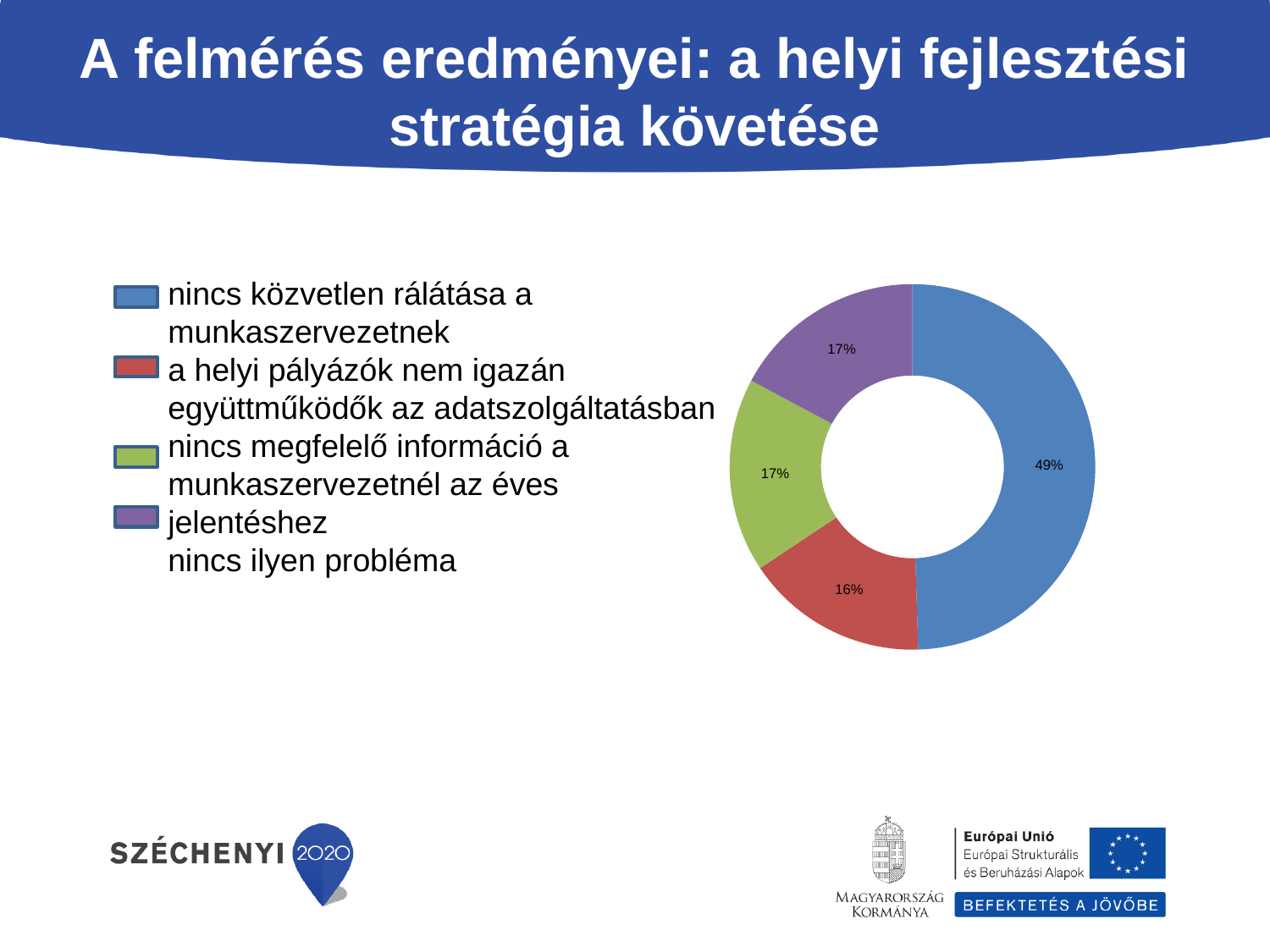
Which is larger: the share for "nincs közvetlen rálátása a munkaszervezetnek" or the share for "a helyi pályázók nem igazán együttműködők az adatszolgáltatásban"? nincs közvetlen rálátása a munkaszervezetnek What colour represents "nincs közvetlen rálátása a munkaszervezetnek" in the chart? Blue What share of the chart does "nincs ilyen probléma" represent? 17% What share of the chart does "a helyi pályázók nem igazán együttműködők az adatszolgáltatásban" represent? 16% How many categories does the chart show? 4 What colour represents "nincs ilyen probléma" in the chart? Purple What share of the chart does "nincs megfelelő információ a munkaszervezetnél az éves jelentéshez" represent? 17% Which category has the smallest share of the chart? a helyi pályázók nem igazán együttműködők az adatszolgáltatásban What share of the chart does "nincs közvetlen rálátása a munkaszervezetnek" represent? 49% Which category has the largest share of the chart? nincs közvetlen rálátása a munkaszervezetnek What is the difference in percentage points between the share for "nincs közvetlen rálátása a munkaszervezetnek" and the share for "nincs ilyen probléma"? 32 percentage points What kind of chart is shown on the slide? Doughnut (pie) chart